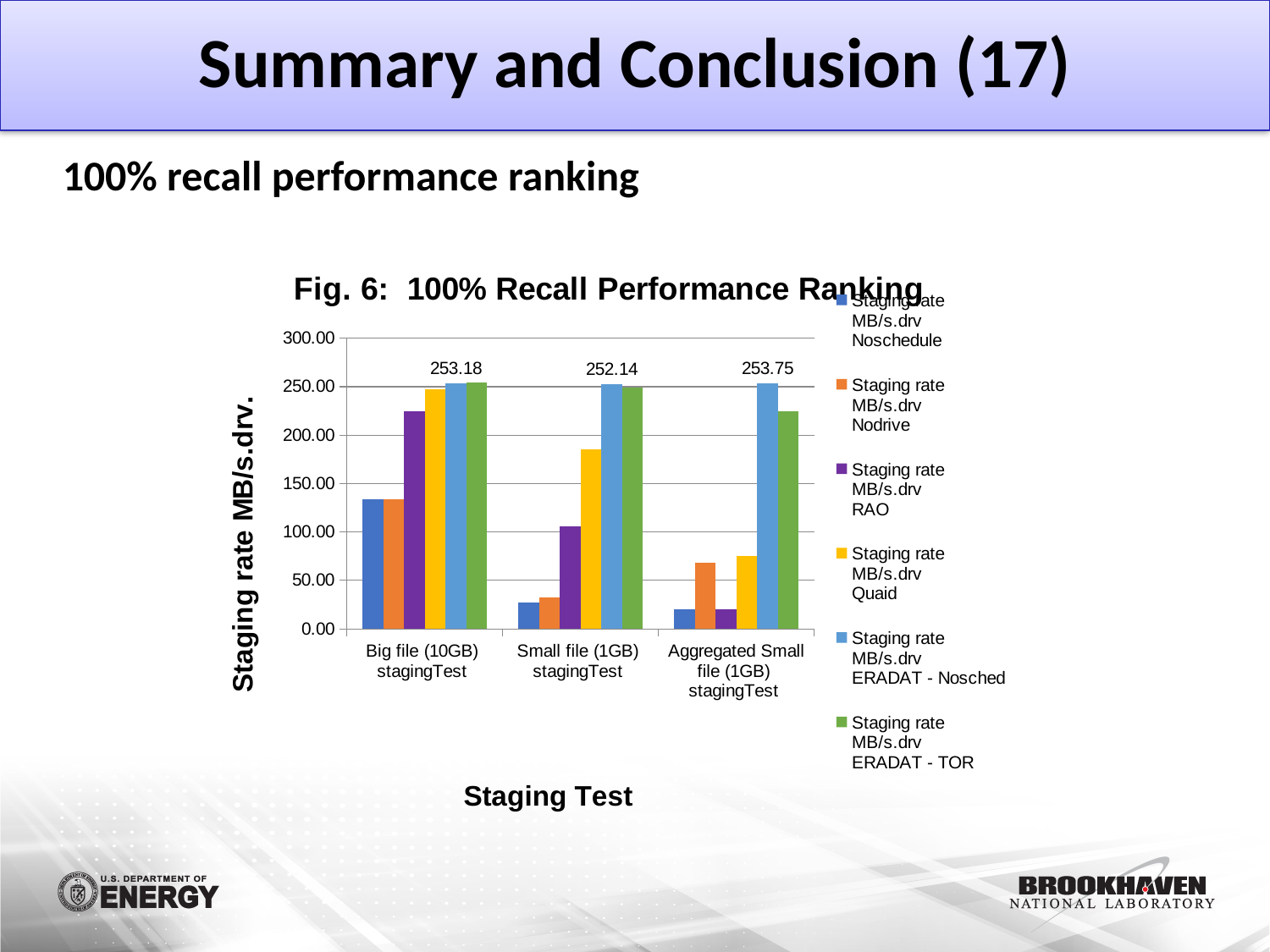
What kind of chart is shown in Fig. 6: 100% Recall Performance Ranking? bar chart Is the RAO staging rate for the Big file (10GB) stagingTest greater or less than 200.00? greater Which is larger: the Quaid staging rate for the Big file (10GB) test or for the Small file (1GB) test? Big file (10GB) stagingTest What is the labelled staging rate for ERADAT - Nosched in the Aggregated Small file (1GB) stagingTest? 253.75 How many staging test categories are shown on the x axis of the chart? 3 What is the labelled staging rate for ERADAT - Nosched in the Big file (10GB) stagingTest? 253.18 Is the Noschedule staging rate for the Big file (10GB) stagingTest greater or less than 150.00? less What is the title of the chart's vertical axis? Staging rate MB/s.drv. Among the three labelled ERADAT - Nosched values, which staging test has the highest value? Aggregated Small file (1GB) stagingTest How many series does the chart's legend list? 6 What is the labelled staging rate for ERADAT - Nosched in the Small file (1GB) stagingTest? 252.14 What is the difference between the labelled ERADAT - Nosched values for the Aggregated Small file (1GB) test and the Small file (1GB) test? 1.61